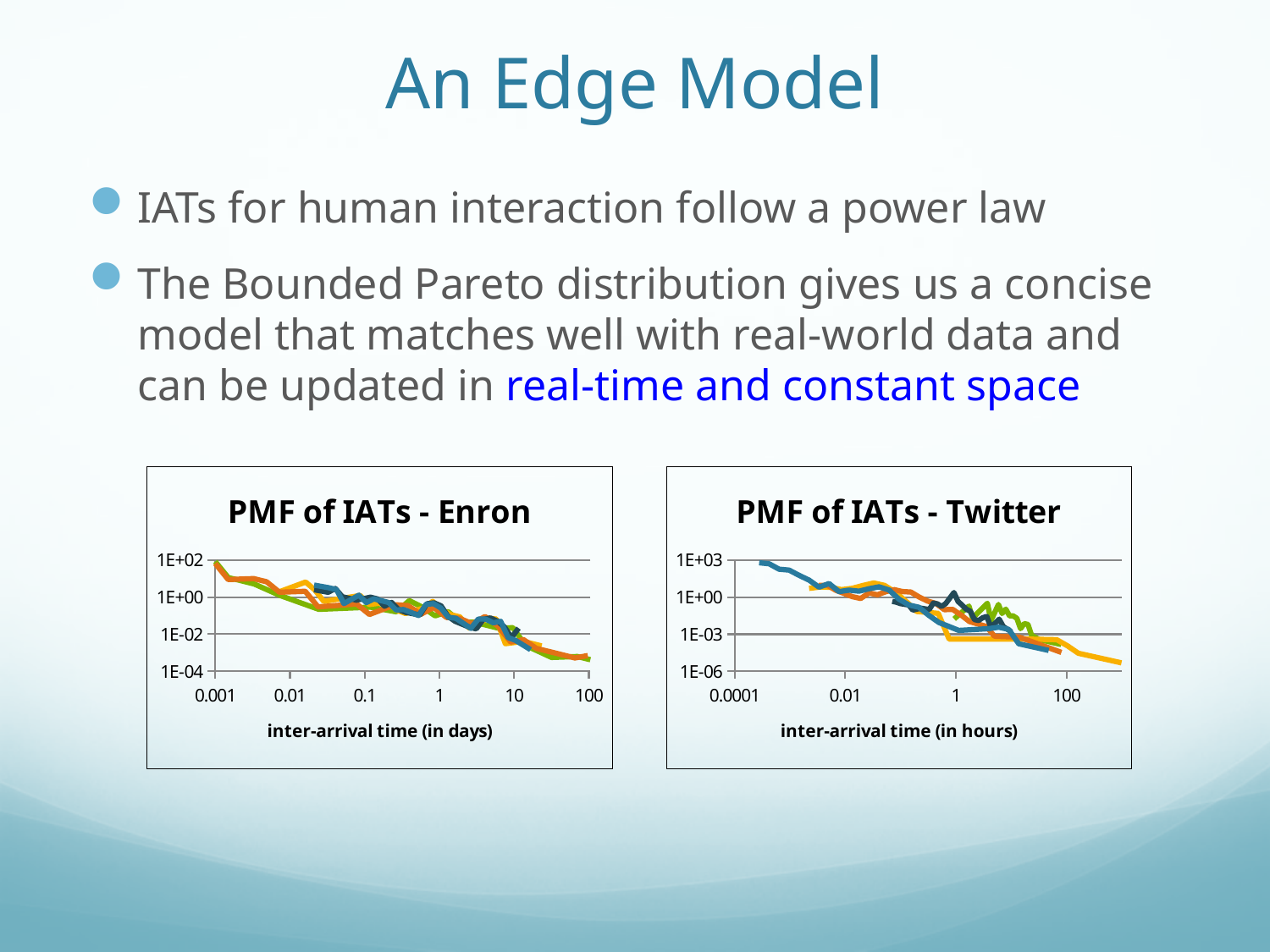
What kind of chart is the 'PMF of IATs - Twitter' chart? line chart What is the title of the chart on the right side of the slide? PMF of IATs - Twitter What kind of chart is the 'PMF of IATs - Enron' chart? line chart In the 'PMF of IATs - Twitter' chart, are the values at an inter-arrival time of 100 hours greater or less than 1E-03? less In the 'PMF of IATs - Twitter' chart, do the values rise or fall as inter-arrival time increases along the x axis? fall What is the x-axis label of the 'PMF of IATs - Enron' chart? inter-arrival time (in days) In the 'PMF of IATs - Enron' chart, do the values rise or fall as inter-arrival time increases along the x axis? fall In the 'PMF of IATs - Enron' chart, are the values at an inter-arrival time of 100 days greater or less than 1E-02? less